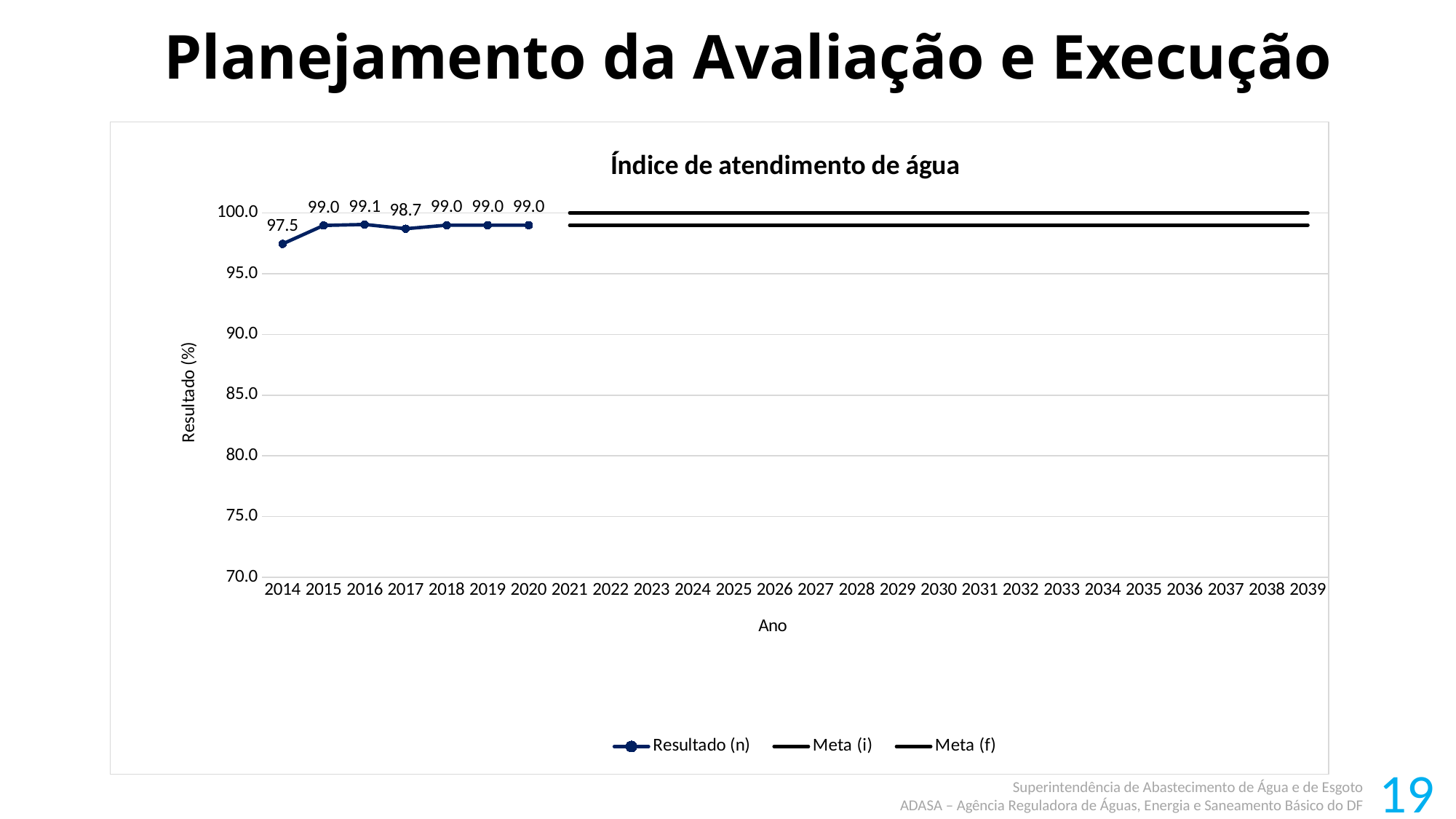
Which is larger, the Resultado (n) value for 2015 or for 2017? 2015 In which year is Resultado (n) lowest? 2014 Is the value of the Meta (i) line greater or less than 95.0? greater In which year is Resultado (n) highest? 2016 How many series does the legend list? 3 What is the value of Resultado (n) for 2014? 97.5 What is the title of the chart? Índice de atendimento de água How many data points are plotted for the Resultado (n) series? 7 What is the difference between the Resultado (n) values for 2016 and 2014? 1.6 What kind of chart is shown? line chart What is the value of Resultado (n) for 2017? 98.7 What is the value of Resultado (n) for 2020? 99.0